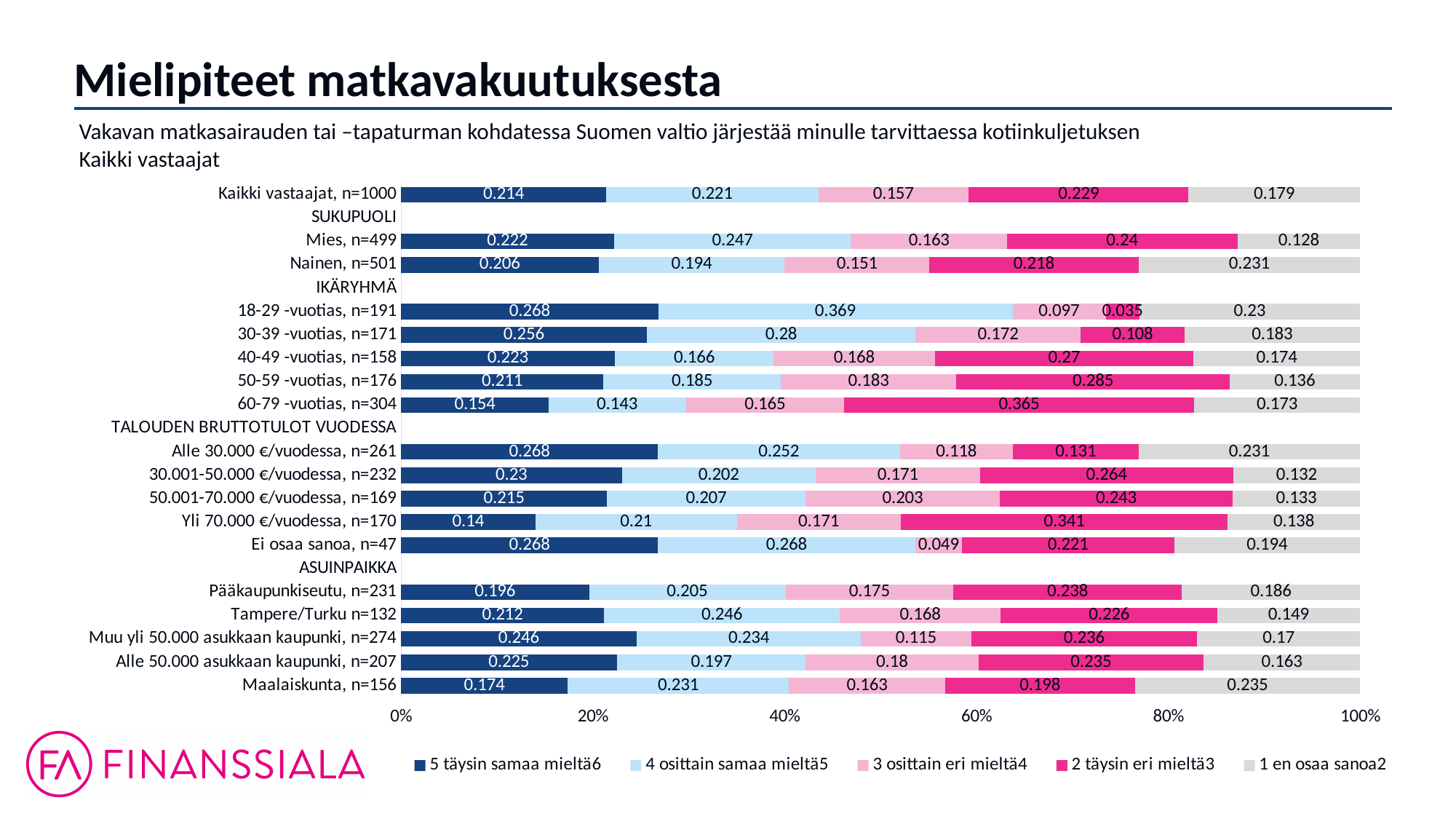
How many bars (respondent groups) are plotted in the chart? 18 Which has the larger "4 osittain samaa mieltä" value, "Mies, n=499" or "Nainen, n=501"? Mies, n=499 Which category has the lowest "5 täysin samaa mieltä" value? Yli 70.000 €/vuodessa, n=170 What is the value of the "5 täysin samaa mieltä" segment for "Kaikki vastaajat, n=1000"? 0.214 What is the value of the "3 osittain eri mieltä" segment for "Ei osaa sanoa, n=47"? 0.049 What is the title of the slide? Mielipiteet matkavakuutuksesta What is the difference between the "1 en osaa sanoa" values for "Nainen, n=501" and "Mies, n=499"? 0.103 What is the total of the stacked bar for "Kaikki vastaajat, n=1000"? 1 How many series does the legend list? 5 What is the value of the "2 täysin eri mieltä" segment for "60-79 -vuotias, n=304"? 0.365 What kind of chart is shown on the slide? Stacked bar chart Among the age groups (IKÄRYHMÄ), which has the highest "4 osittain samaa mieltä" value? 18-29 -vuotias, n=191